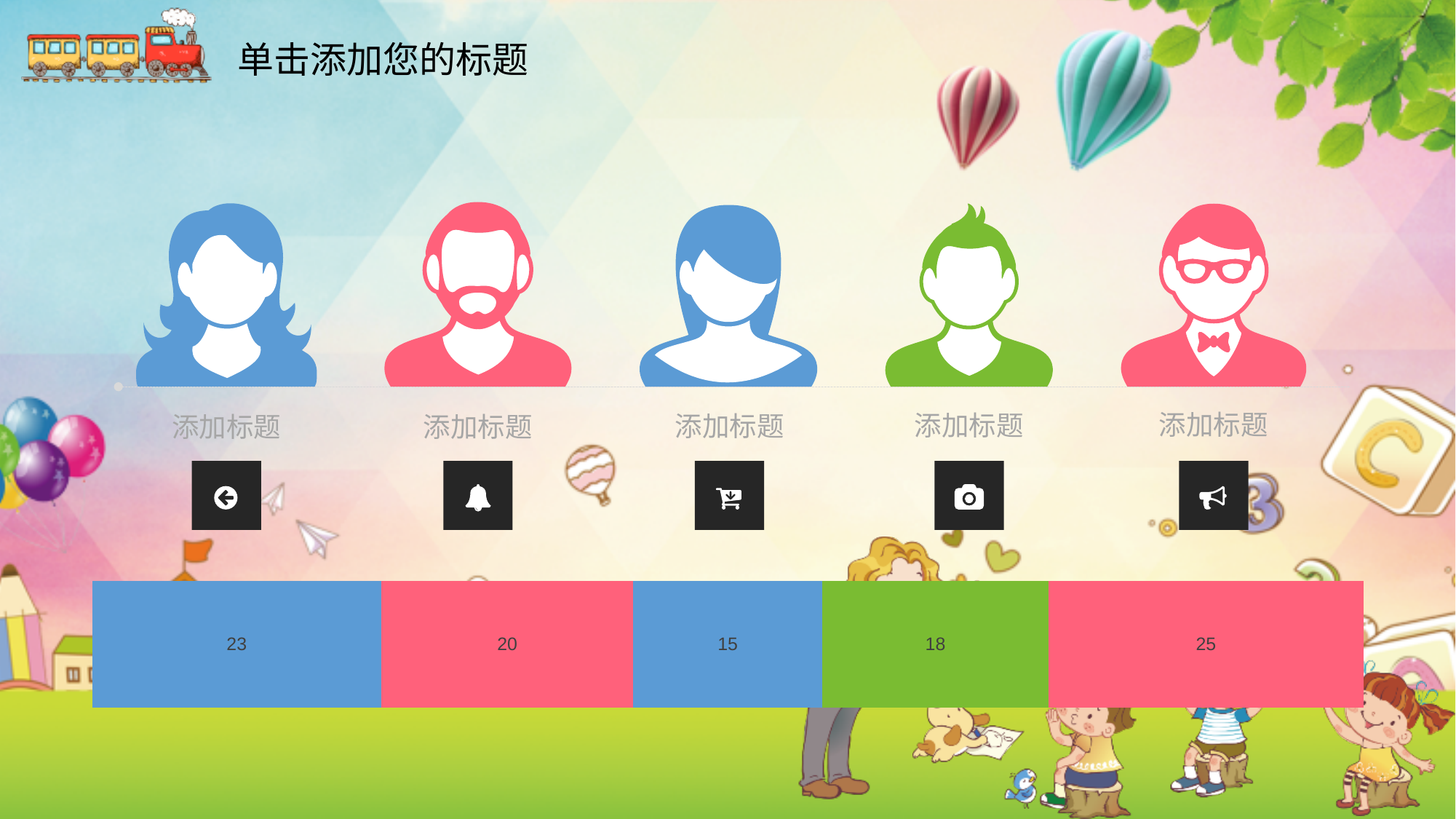
What kind of chart is shown at the bottom of the slide? bar chart What value is printed on the leftmost (first) segment of the stacked bar? 23 What value is printed on the middle (third) segment of the stacked bar? 15 What value is printed on the second segment from the left of the stacked bar? 20 How many segments make up the stacked bar at the bottom of the slide? 5 What is the difference between the largest segment value (25) and the smallest segment value (15) in the stacked bar? 10 What is the total of all five segment values in the stacked bar? 101 Which segment of the stacked bar has the lowest value? the middle (third) segment, 15 What value is printed on the rightmost (fifth) segment of the stacked bar? 25 What value is printed on the green segment of the stacked bar? 18 Which segment of the stacked bar has the highest value? the rightmost (fifth) segment, 25 Which is larger in the stacked bar: the first segment or the second segment? the first segment (23)